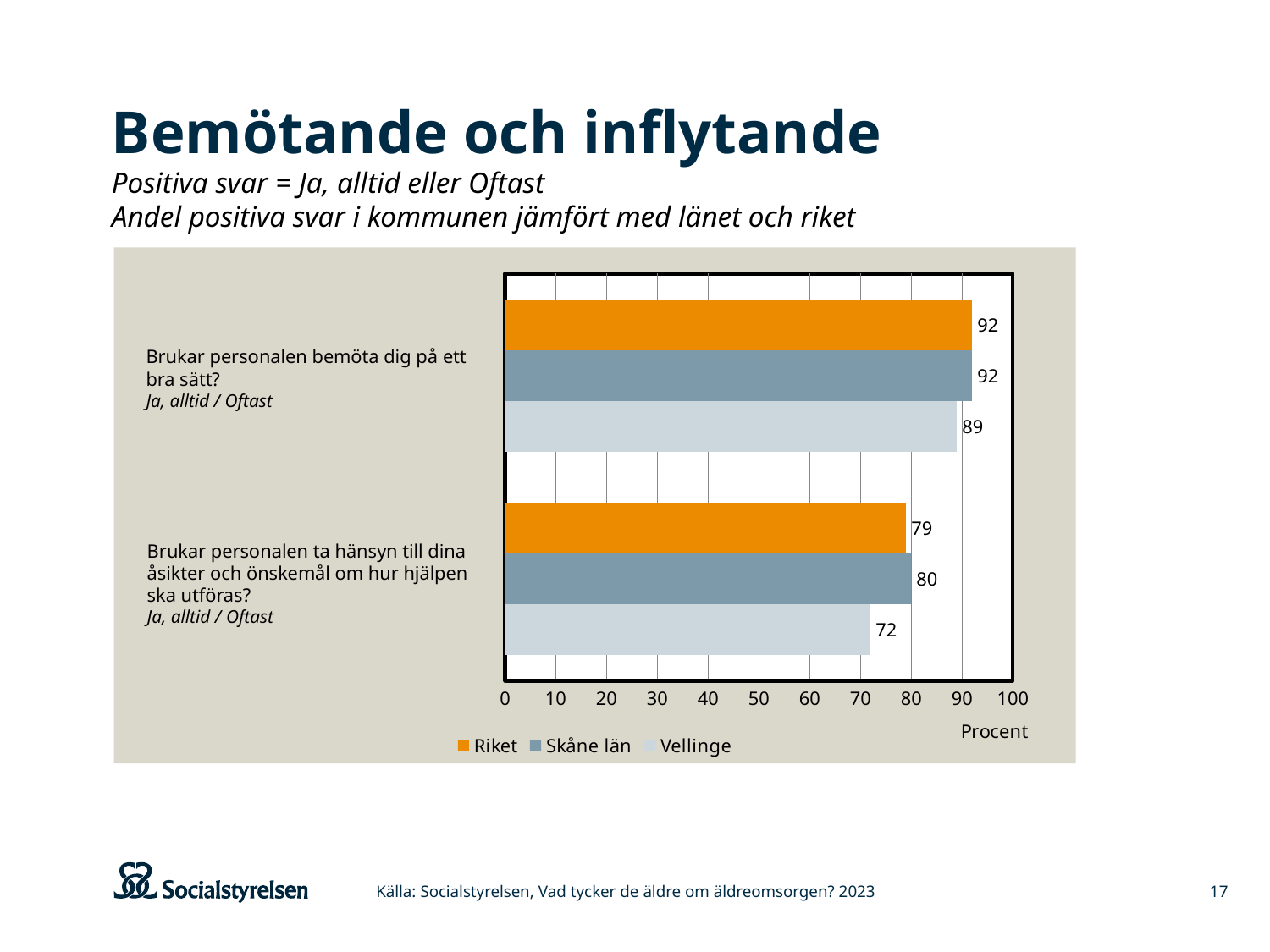
How many series does the legend list? 3 What is the difference between the Riket and Vellinge values on the question "Brukar personalen bemöta dig på ett bra sätt?"? 3 What is the difference between the Skåne län and Vellinge values on the question "Brukar personalen ta hänsyn till dina åsikter och önskemål om hur hjälpen ska utföras?"? 8 What is the value for Skåne län on the question "Brukar personalen ta hänsyn till dina åsikter och önskemål om hur hjälpen ska utföras?"? 80 What is the label on the horizontal axis of the chart? Procent Is the value for Vellinge on "Brukar personalen ta hänsyn till dina åsikter och önskemål om hur hjälpen ska utföras?" greater or less than 80? less Which series has the lowest value on the question "Brukar personalen ta hänsyn till dina åsikter och önskemål om hur hjälpen ska utföras?"? Vellinge What is the value for Vellinge on the question "Brukar personalen ta hänsyn till dina åsikter och önskemål om hur hjälpen ska utföras?"? 72 What kind of chart is shown on the slide? Bar chart Which is larger: the Vellinge value for "Brukar personalen bemöta dig på ett bra sätt?" or the Vellinge value for "Brukar personalen ta hänsyn till dina åsikter och önskemål om hur hjälpen ska utföras?"? Brukar personalen bemöta dig på ett bra sätt? What is the value for Riket on the question "Brukar personalen ta hänsyn till dina åsikter och önskemål om hur hjälpen ska utföras?"? 79 What is the value for Vellinge on the question "Brukar personalen bemöta dig på ett bra sätt?"? 89